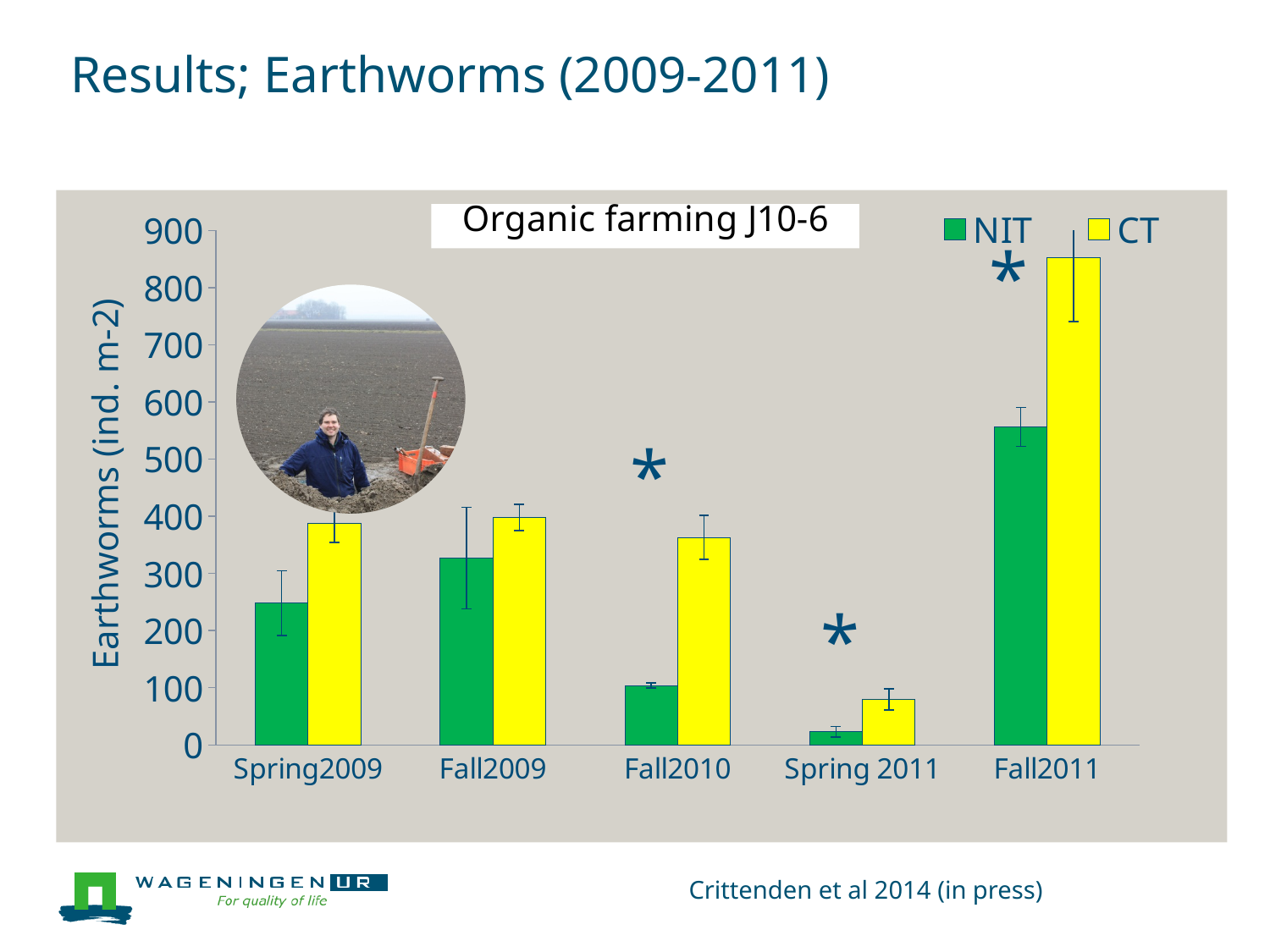
In which sampling period is the NIT value lowest? Spring 2011 How many sampling periods are shown on the x axis? 5 In Fall2011, which series has the larger value, NIT or CT? CT Is the NIT value for Spring 2011 greater or less than 100? less Is the NIT value for Fall2011 greater or less than 500? greater Which colour represents the CT series? yellow How many series does the legend list? 2 Is the CT value for Fall2011 greater or less than 800? greater In Fall2010, which series has the larger value, NIT or CT? CT What kind of chart is shown on the slide? bar chart In which sampling period is the CT value highest? Fall2011 What is the title of the chart? Organic farming J10-6